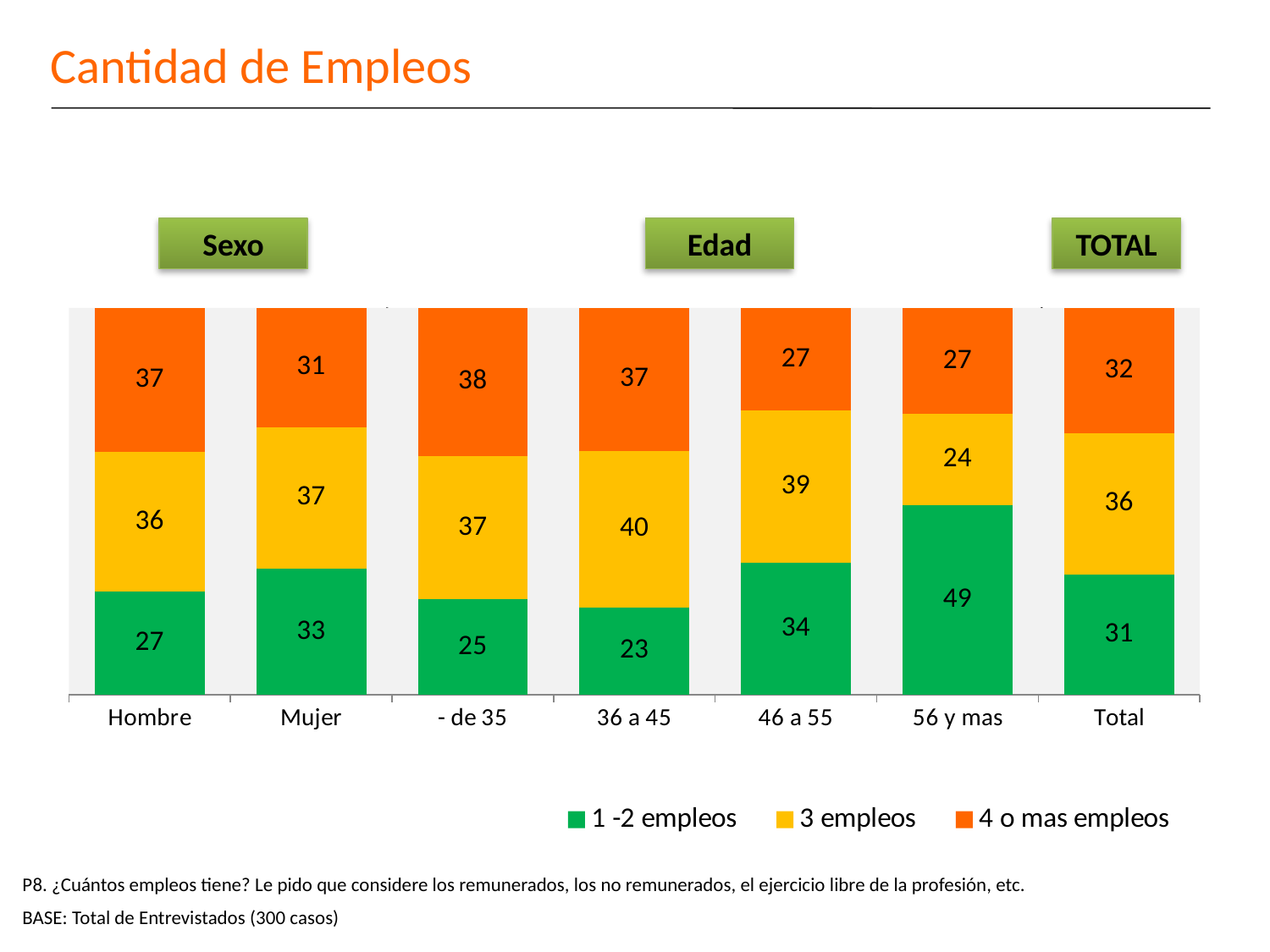
Which category has the lowest value for '1 -2 empleos'? 36 a 45 What is the difference between the '1 -2 empleos' values for 'Mujer' and 'Hombre'? 6 What is the total of the stacked bar for 'Hombre'? 100 What is the value for '1 -2 empleos' in the '56 y mas' category? 49 Which category has the highest value for '1 -2 empleos'? 56 y mas What kind of chart is shown on the slide? Stacked bar chart How many categories are shown on the x axis? 7 How many series does the legend list? 3 What is the value for '3 empleos' in the '36 a 45' category? 40 Which category has the lowest value for '3 empleos'? 56 y mas Which is larger: the '4 o mas empleos' value for '- de 35' or for '46 a 55'? - de 35 What is the value for '4 o mas empleos' in the 'Mujer' category? 31